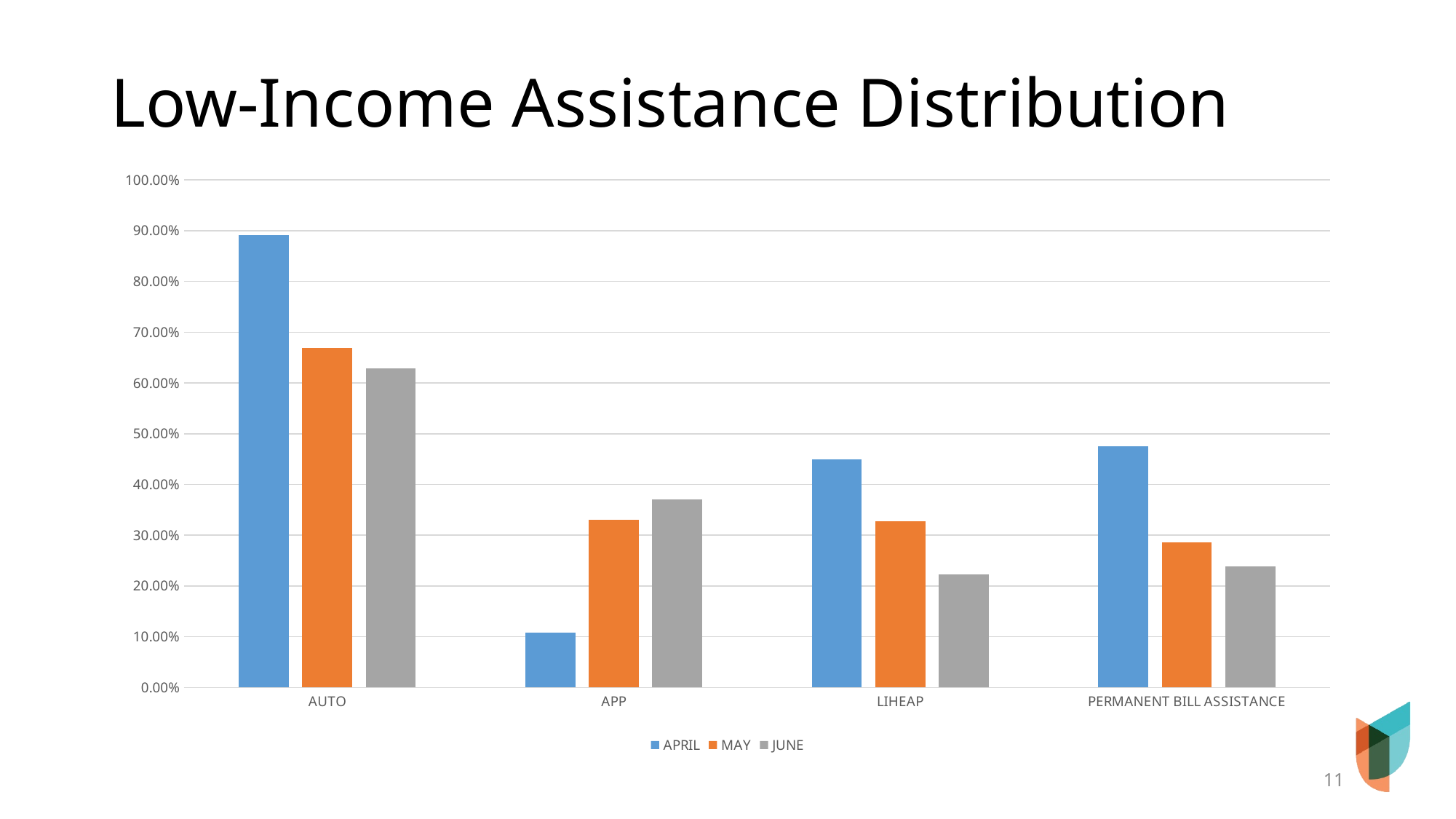
How many categories are shown on the x axis of the chart? 4 For AUTO, do the values rise or fall from APRIL to JUNE? fall How many series does the legend list? 3 Is the JUNE value for LIHEAP greater or less than 30.00%? less Is the APRIL value for APP greater or less than 20.00%? less For APP, which is larger: the MAY value or the JUNE value? JUNE Which category has the highest APRIL value? AUTO Is the APRIL value for AUTO greater or less than 80.00%? greater Which is larger: the APRIL value for AUTO or the APRIL value for LIHEAP? AUTO Which category has the lowest APRIL value? APP What is the title of the slide? Low-Income Assistance Distribution What kind of chart is shown on the slide? bar chart